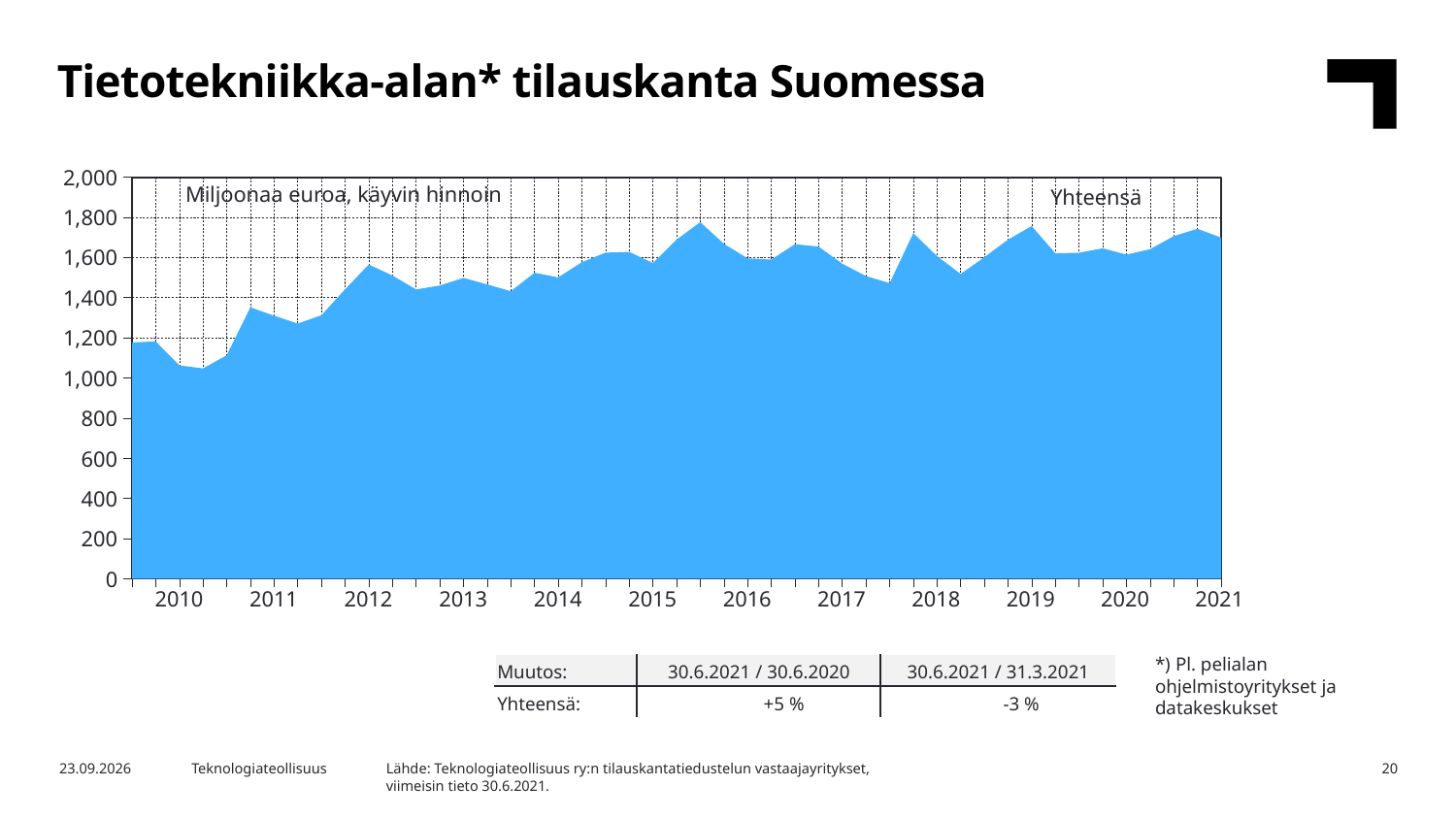
What is the highest value shown on the y axis? 2,000 What is the title of the chart on the slide? Tietotekniikka-alan* tilauskanta Suomessa Is the lowest point of the series, in 2010, greater or less than 1,200? less What kind of chart is shown on the slide? area chart Is the peak value in 2015 greater or less than 1,600? greater Is the value at the 2021 end of the series greater or less than 1,600? greater Which is larger: the value at the start of 2010 or the value at the end of the series in 2021? 2021 Overall, do the values rise or fall from 2010 to 2021? rise What unit label is printed inside the chart area? Miljoonaa euroa, käyvin hinnoin How many year labels are shown on the x axis? 12